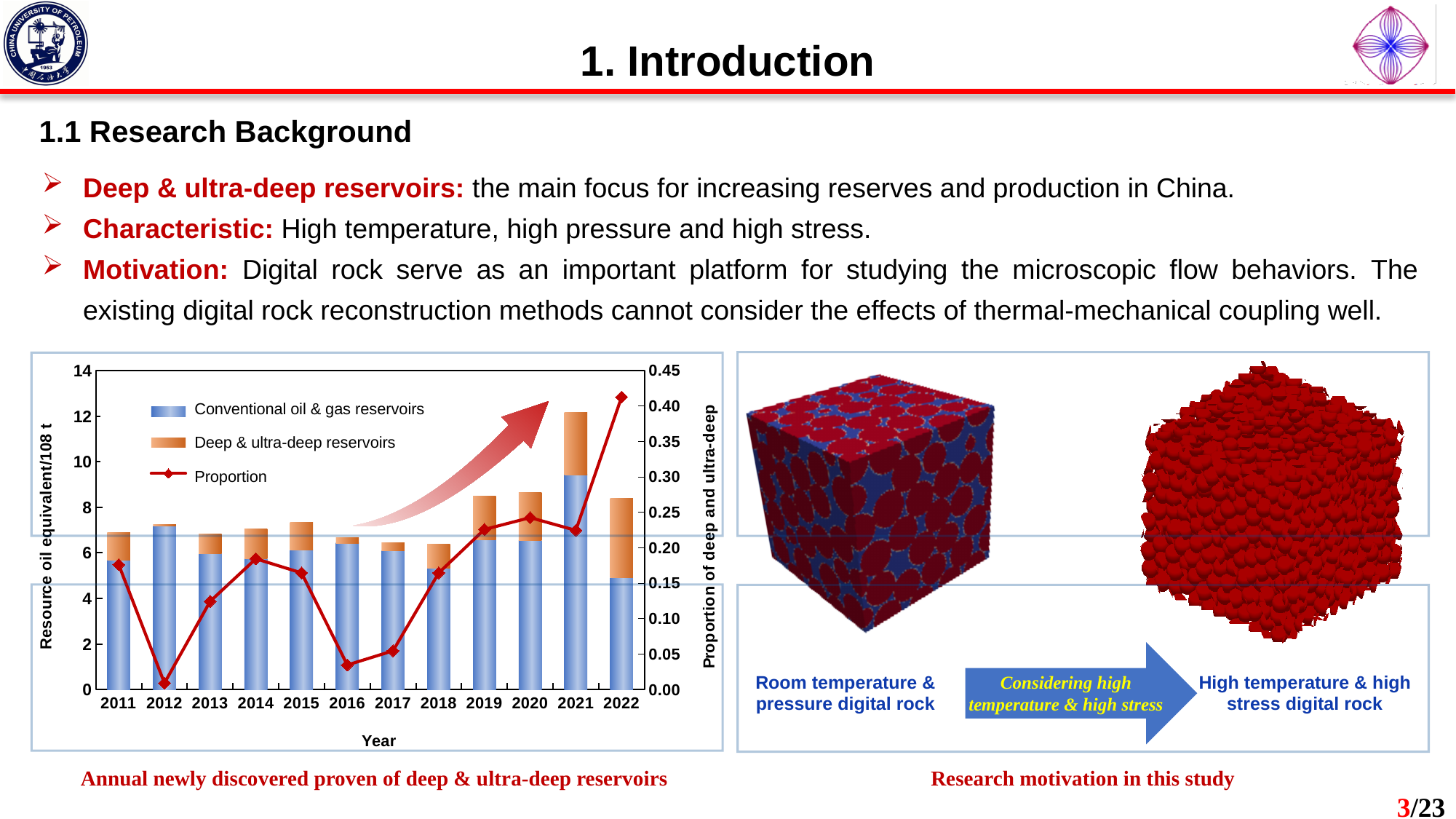
How many series does the chart legend list? 3 Is the total stacked bar for 2021 greater or less than 10? greater Is the Proportion value for 2022 greater or less than 0.35? greater Which year has the larger total stacked bar, 2021 or 2022? 2021 Does the Proportion line rise or fall from 2016 to 2020? rise How many years are shown on the x axis of the chart? 12 Which year has the tallest stacked bar? 2021 What kind of chart is shown on the slide? A combination chart of stacked bars with a line In which year is the Proportion line at its highest? 2022 Is the Proportion value for 2012 greater or less than 0.05? less What is the label of the left vertical axis of the chart? Resource oil equivalent/108 t In which year is the Proportion line at its lowest? 2012